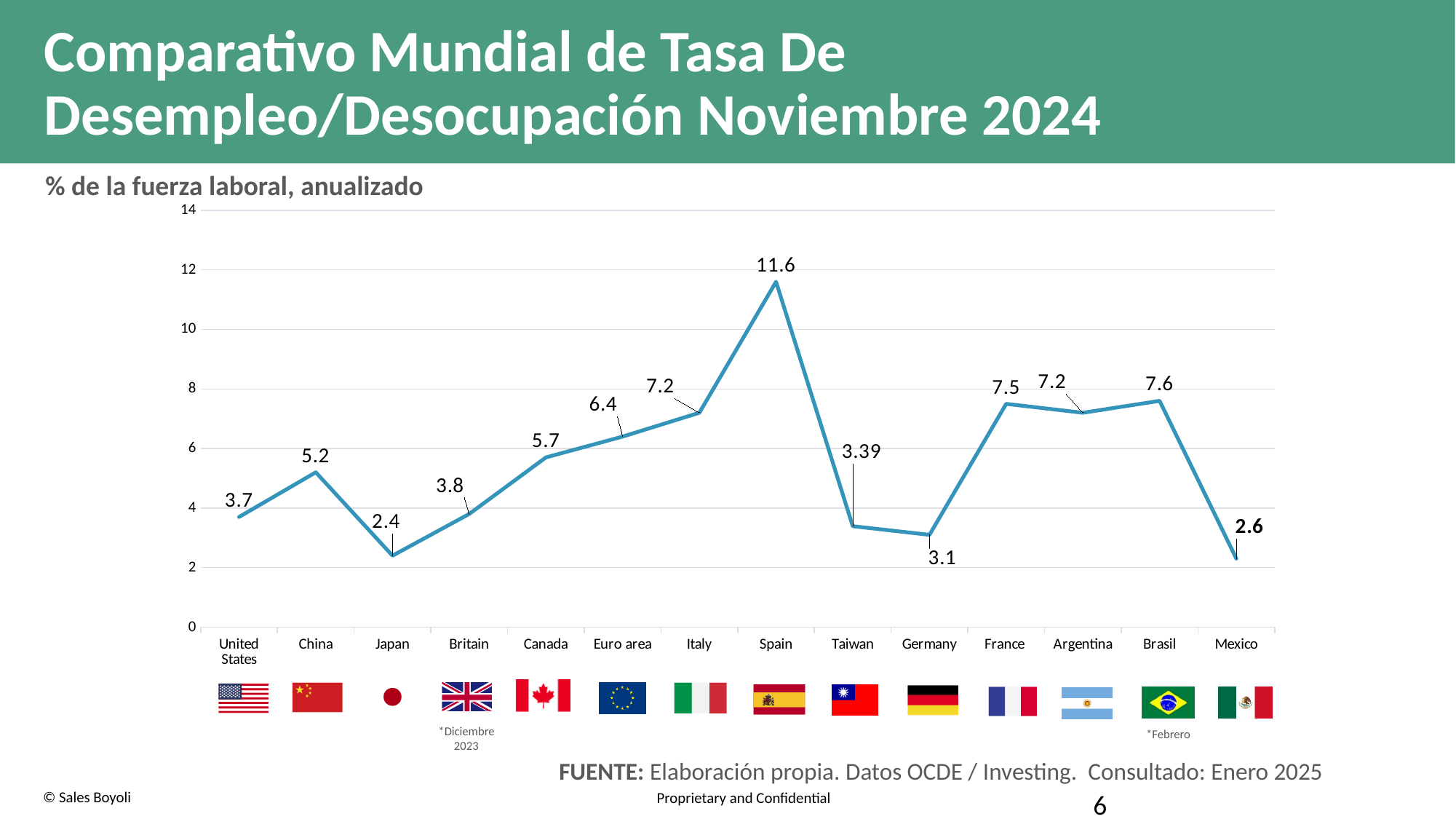
What type of chart is shown on the slide? Line chart What is the unemployment rate shown for Spain? 11.6 What is the difference between the values for Spain and Italy? 4.4 Which has a higher value, France or Canada? France How many countries or regions are plotted on the chart? 14 What is the value shown for the Euro area? 6.4 Which country has the highest unemployment rate on the chart? Spain What is the value plotted for Mexico? 2.6 What value is shown for Taiwan? 3.39 Is the value for Spain greater or less than 10? greater What is the difference between the values for Brasil and Mexico? 5.0